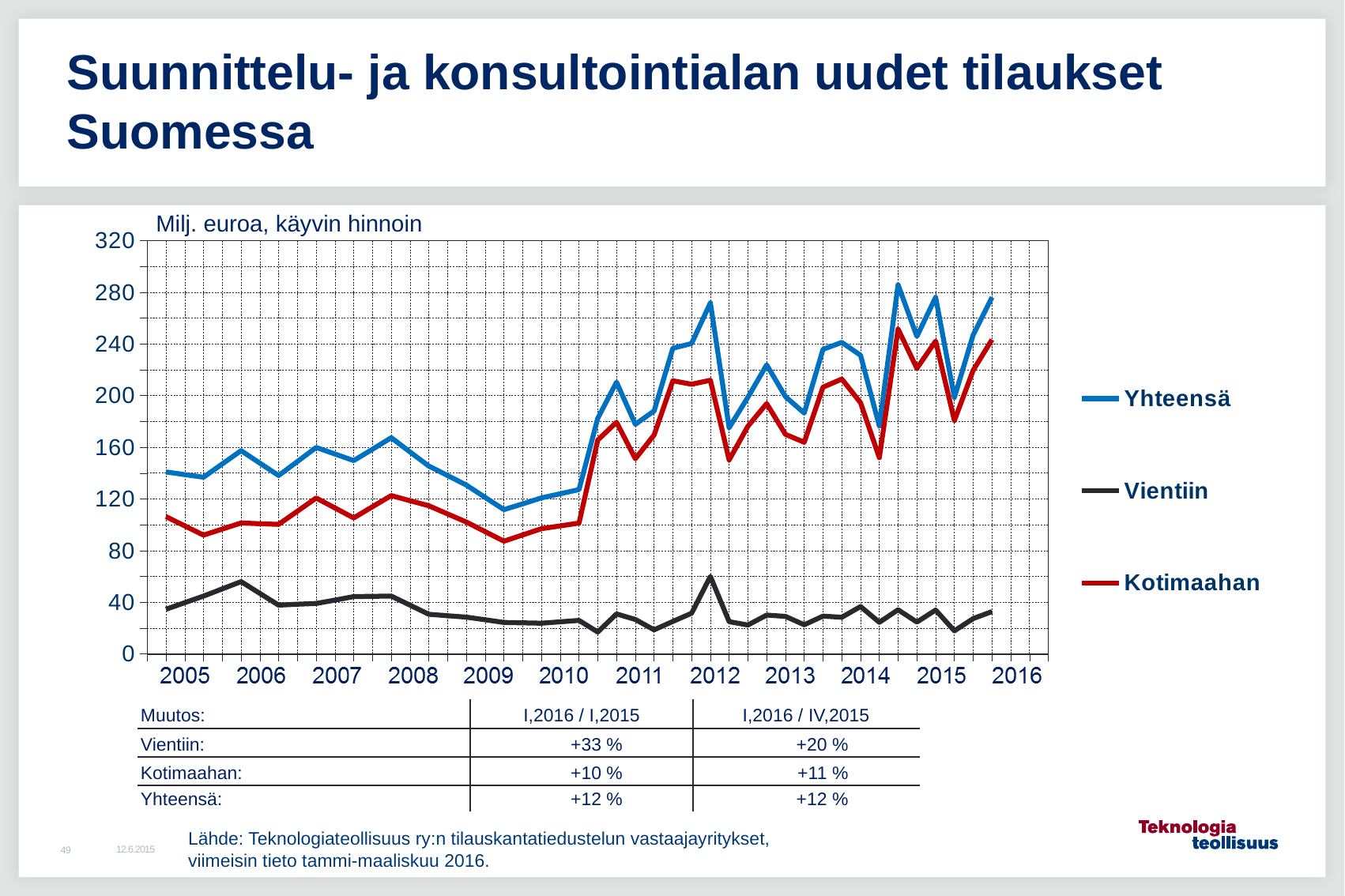
What kind of chart is shown on the slide? line chart Is the value for Kotimaahan at its 2012 peak greater or less than 200? greater Is the value for Vientiin at its 2012 peak greater or less than 80? less Which series has the highest values throughout the chart? Yhteensä Is the value for Yhteensä at its lowest point in 2009 greater or less than 120? less Which series has the lowest values throughout the chart? Vientiin How many series does the chart legend list? 3 Which is larger in 2014, the Yhteensä value or the Kotimaahan value? Yhteensä What unit label is printed above the chart's y axis? Milj. euroa, käyvin hinnoin Which series is shown in red in the chart? Kotimaahan Do the Yhteensä values overall rise or fall from 2005 to 2016? rise